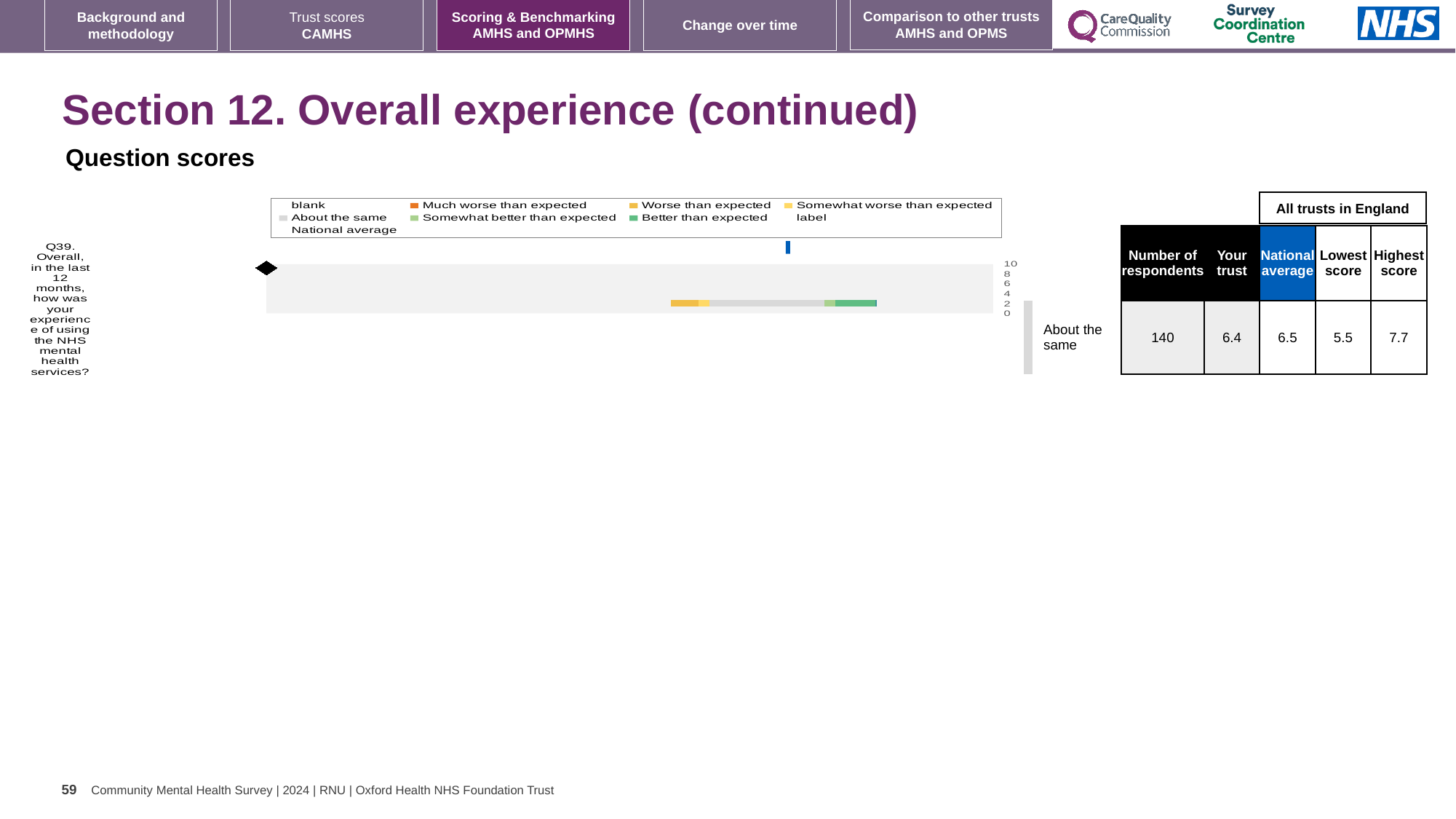
In the table next to the chart, what is the national average score for Q39? 6.5 In the table next to the chart, what is the highest score among all trusts in England for Q39? 7.7 How many questions (categories) are plotted in the chart? 1 In the table next to the chart, what is the number of respondents for Q39? 140 How is the trust's Q39 result categorised relative to expectation, according to the label beside the chart? About the same In the table next to the chart, which is larger for Q39: the 'Your trust' score or the national average? National average In the table next to the chart, what is the lowest score among all trusts in England for Q39? 5.5 What kind of chart is shown on the slide? bar chart Which question is plotted in the chart? Q39. Overall, in the last 12 months, how was your experience of using the NHS mental health services? In the table next to the chart, what is the difference between the highest score and the lowest score for Q39? 2.2 What colour does the legend use for 'Better than expected'? green In the table next to the chart, what is the 'Your trust' score for Q39? 6.4